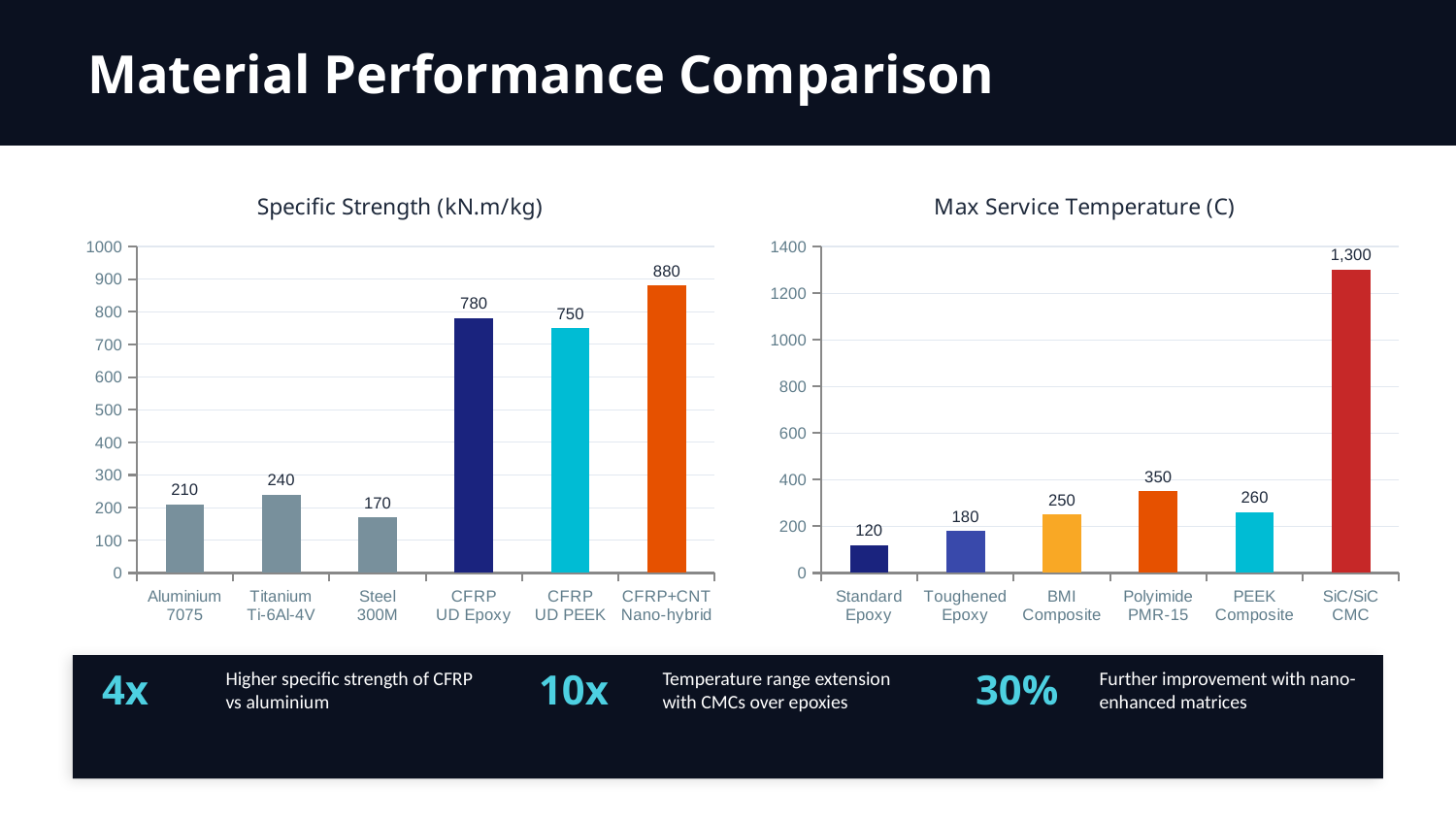
In the Specific Strength (kN.m/kg) chart, what is the value for Titanium Ti-6Al-4V? 240 In the Specific Strength (kN.m/kg) chart, which material has the highest specific strength? CFRP+CNT Nano-hybrid In the Max Service Temperature (C) chart, what is the difference between SiC/SiC CMC and Toughened Epoxy? 1,120 In the Specific Strength (kN.m/kg) chart, which material has the lowest specific strength? Steel 300M In the Max Service Temperature (C) chart, which material has the lowest max service temperature? Standard Epoxy In the Specific Strength (kN.m/kg) chart, how many materials are shown? 6 What type of chart is the Max Service Temperature (C) chart? Bar chart In the Max Service Temperature (C) chart, which material has the highest max service temperature? SiC/SiC CMC In the Max Service Temperature (C) chart, which is larger, the value for BMI Composite or PEEK Composite? PEEK Composite What is the title of the chart on the left side of the slide? Specific Strength (kN.m/kg) In the Specific Strength (kN.m/kg) chart, what is the difference between CFRP UD Epoxy and CFRP UD PEEK? 30 In the Max Service Temperature (C) chart, what is the value for Polyimide PMR-15? 350